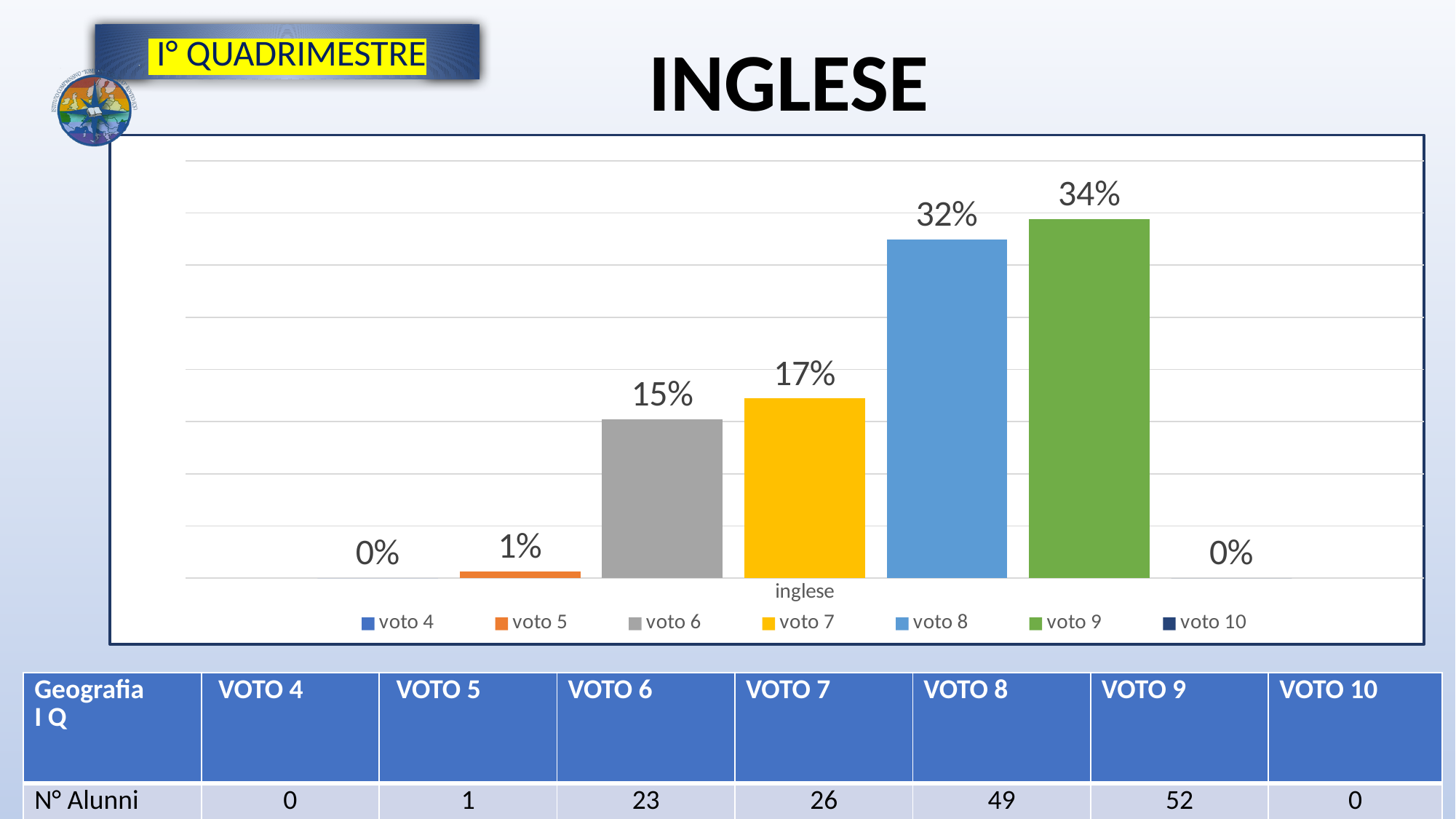
Which is larger, the percentage for voto 8 or for voto 7? voto 8 What kind of chart is shown on the slide? bar chart What percentage is shown for voto 9 in the chart? 34% What is the difference in percentage points between voto 9 and voto 8? 2% How many series does the legend list? 7 What is the category label shown on the x axis of the chart? inglese What percentage is shown for voto 5 in the chart? 1% Which series are shown with 0% in the chart? voto 4 and voto 10 What is the difference in percentage points between voto 7 and voto 6? 2% What percentage is shown for voto 6 in the chart? 15% Which series has the highest percentage in the chart? voto 9 What colour is the bar for voto 7? yellow